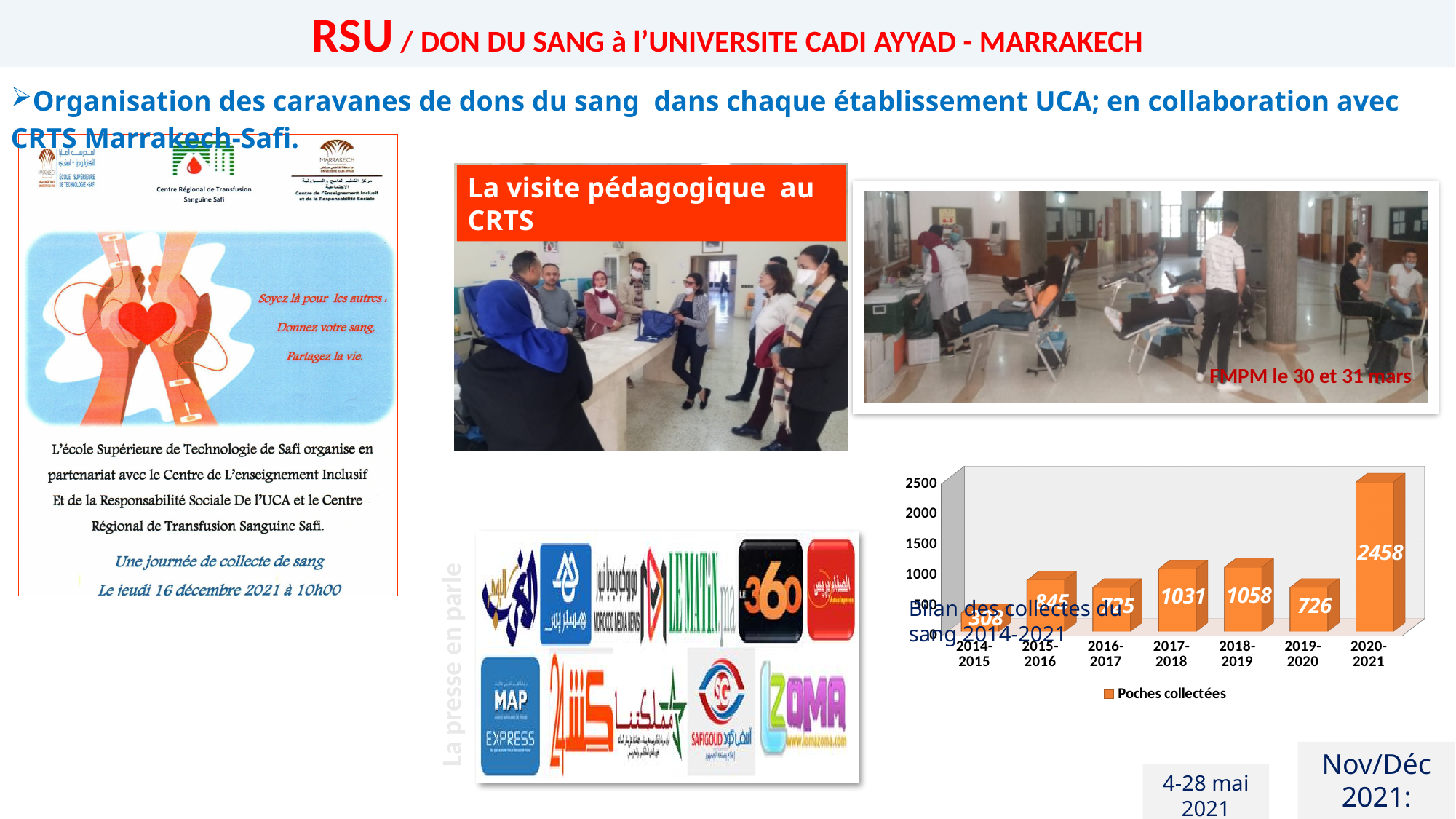
In the bar chart, is the value for 2015-2016 greater or less than 1000? less What kind of chart is shown at the bottom right of the slide? bar chart Which period has the lowest number of poches collectées in the bar chart? 2014-2015 Which period has the highest number of poches collectées in the bar chart? 2020-2021 In the bar chart, what is the value for 2018-2019? 1058 In the bar chart, what is the difference between the values for 2020-2021 and 2019-2020? 1732 In the bar chart, what is the value for 2017-2018? 1031 In the bar chart, which is larger: the value for 2017-2018 or the value for 2019-2020? 2017-2018 In the bar chart, what is the value for 2019-2020? 726 In the bar chart, how many poches collectées are shown for 2020-2021? 2458 How many periods (categories) are shown on the x axis of the bar chart? 7 What series name does the legend of the bar chart show? Poches collectées